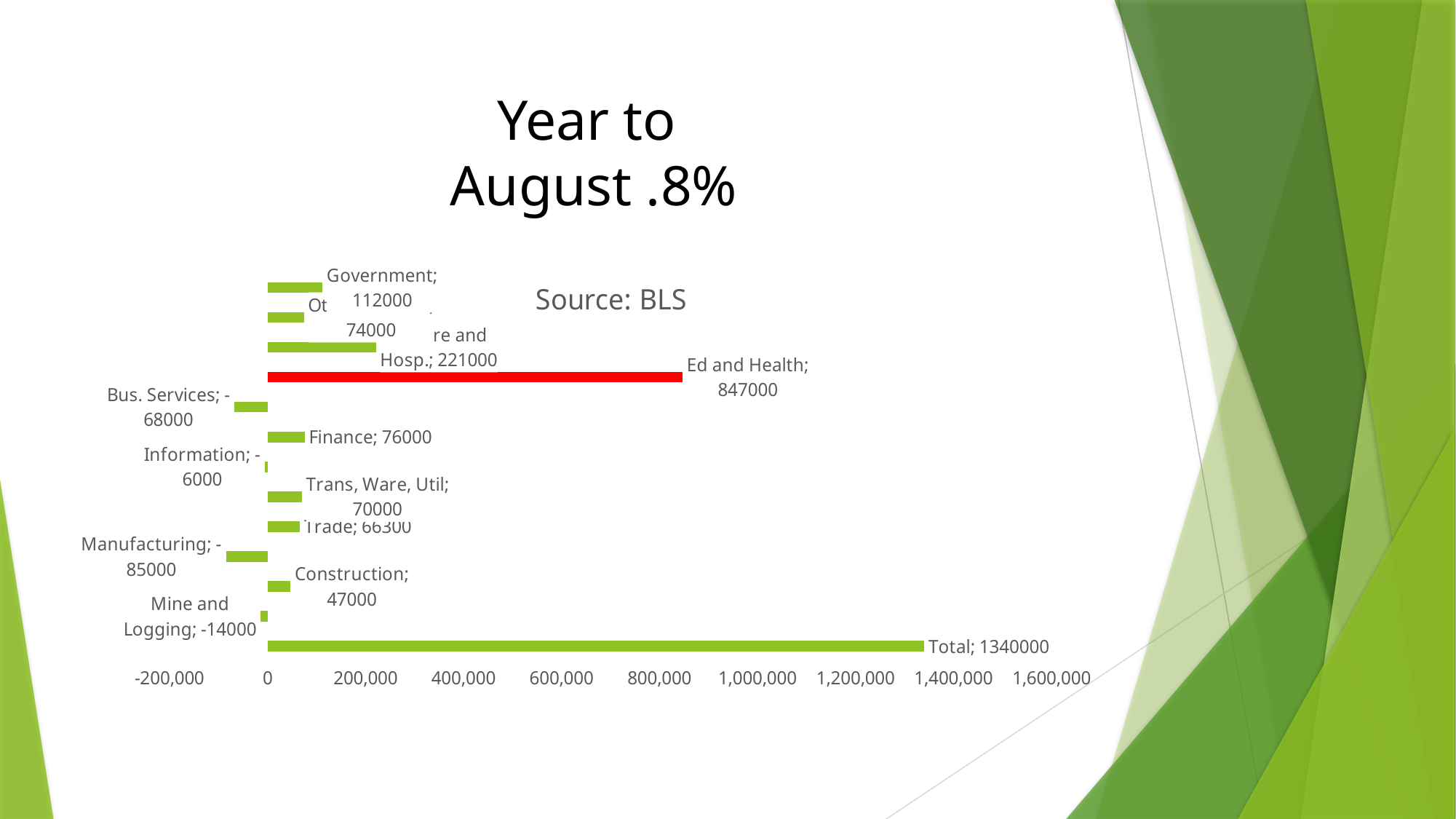
Which category has the longest bar? Total What is the value for Manufacturing? -85000 What is the value for Ed and Health? 847000 What is the difference between the Finance value and the Trans, Ware, Util value? 6000 How many bars are plotted in the chart? 13 Which category has the lowest value? Manufacturing Which is larger, the value for Finance or the value for Trade? Finance What is the value for Government? 112000 What kind of chart is shown on the slide? bar chart Which category's bar is coloured red? Ed and Health What is the value for Construction? 47000 Is the value for Ed and Health greater or less than 800,000? greater